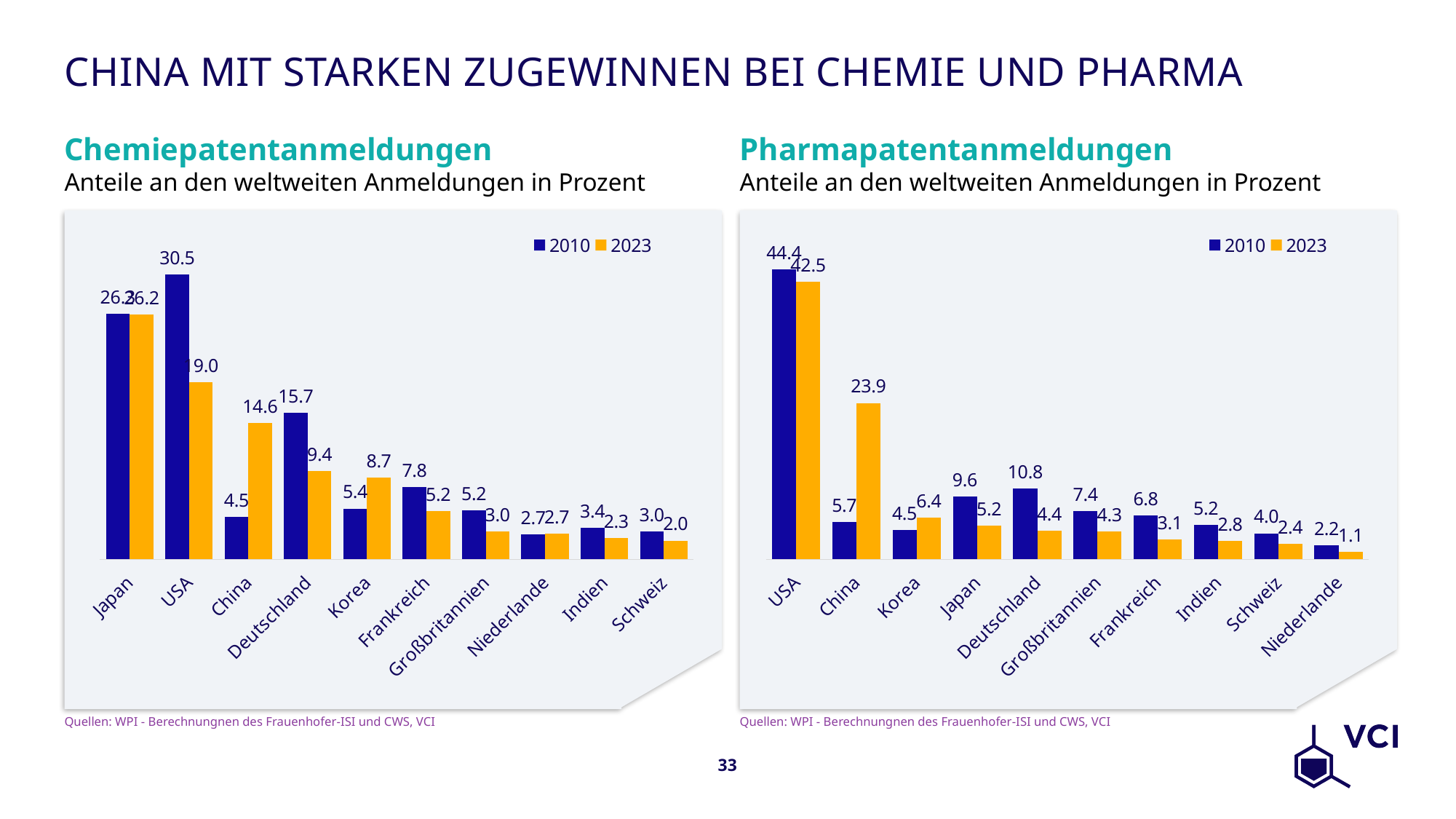
How many series does the legend of the Pharmapatentanmeldungen chart list? 2 In the Pharmapatentanmeldungen chart, which country has the lowest value for 2023? Niederlande In the Pharmapatentanmeldungen chart, what is the value for Deutschland in 2010? 10.8 What type of chart is the Pharmapatentanmeldungen chart? Bar chart In the Chemiepatentanmeldungen chart, which is larger for Korea: the 2010 value or the 2023 value? 2023 In the Chemiepatentanmeldungen chart, what is the value for USA in 2010? 30.5 In the Pharmapatentanmeldungen chart, what is the difference between the 2023 and 2010 values for China? 18.2 In the Chemiepatentanmeldungen chart, what is the value for China in 2023? 14.6 How many countries are shown in the Chemiepatentanmeldungen chart? 10 In the Pharmapatentanmeldungen chart, what is the value for China in 2023? 23.9 In the Chemiepatentanmeldungen chart, what is the difference between the 2010 and 2023 values for Deutschland? 6.3 In the Chemiepatentanmeldungen chart, which country has the highest value for 2010? USA